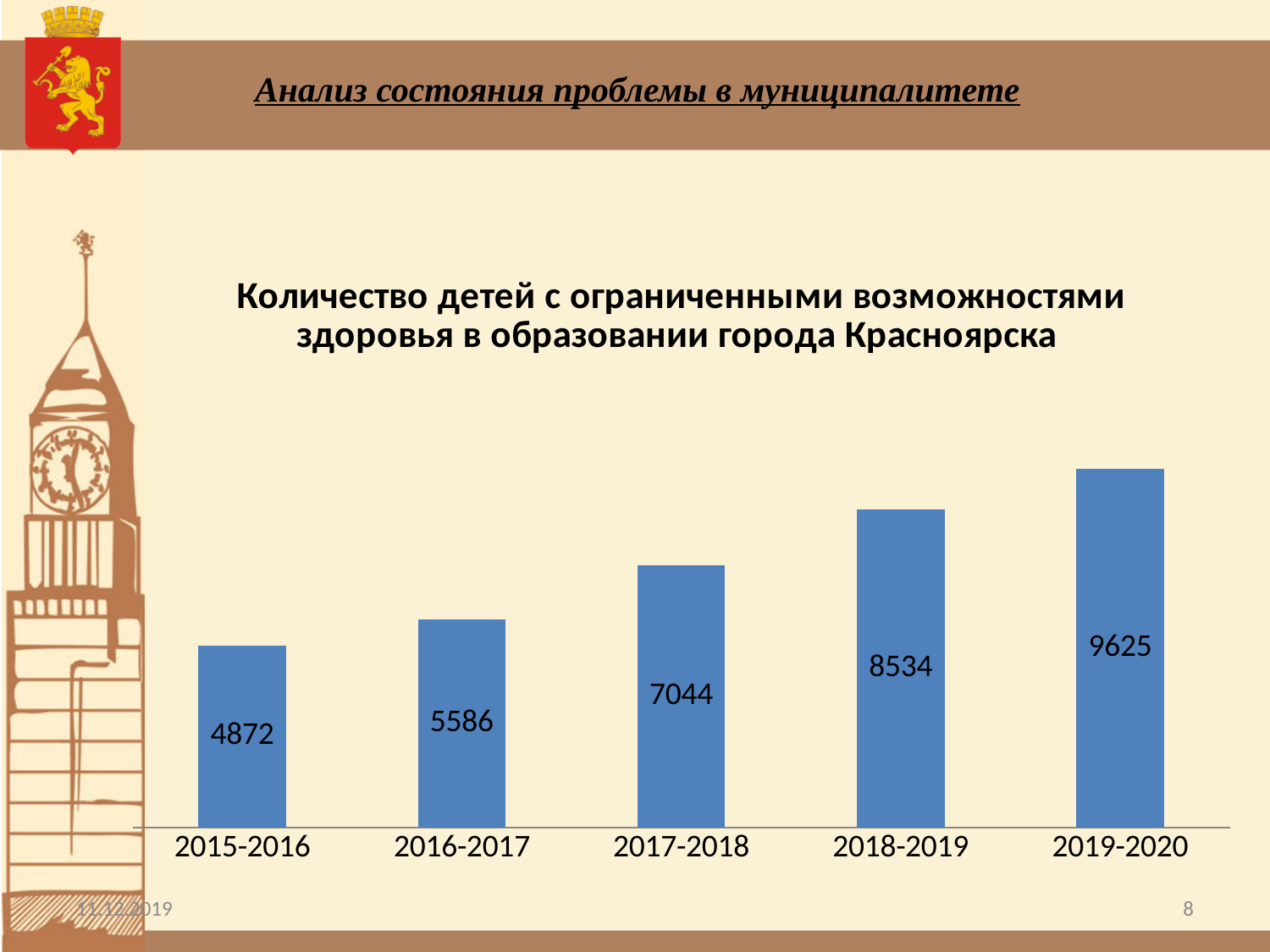
What is the value for 2015-2016? 4872 What kind of chart is this? bar chart Which is larger, the value for 2016-2017 or the value for 2017-2018? 2017-2018 What is the difference between the values for 2018-2019 and 2017-2018? 1490 What is the title of the chart? Количество детей с ограниченными возможностями здоровья в образовании города Красноярска How many periods are shown on the x axis? 5 Which period has the lowest value? 2015-2016 What is the difference between the values for 2019-2020 and 2015-2016? 4753 What is the value for 2017-2018? 7044 What is the value for 2019-2020? 9625 Which period has the highest value? 2019-2020 Do the values rise or fall from 2015-2016 to 2019-2020? rise